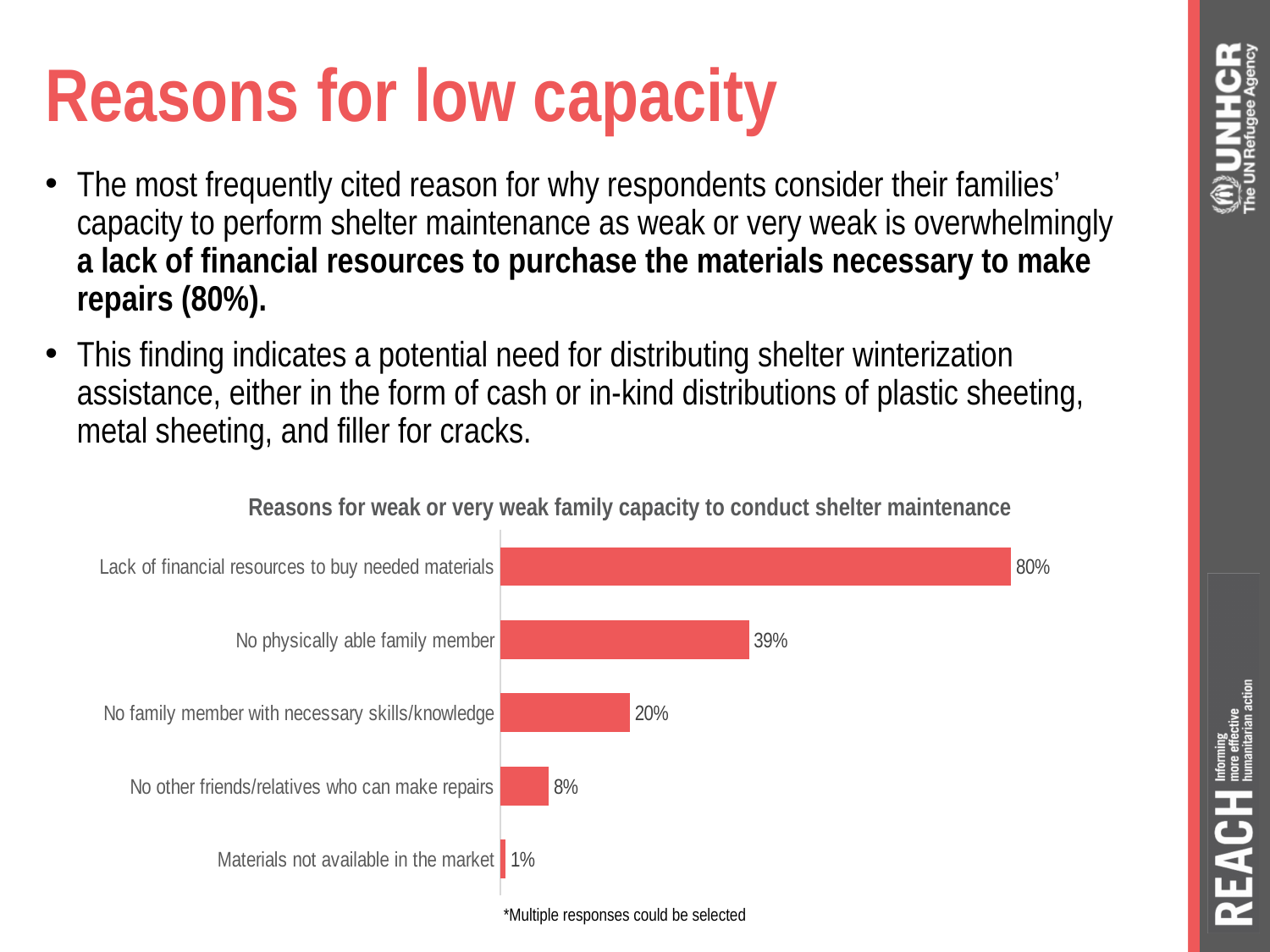
Which reason has the lowest value in the chart? Materials not available in the market What percentage of respondents cited 'Lack of financial resources to buy needed materials' as a reason? 80% Which reason has the highest value in the chart? Lack of financial resources to buy needed materials What is the difference between the values for 'Lack of financial resources to buy needed materials' and 'No physically able family member'? 41% What is the value for 'No family member with necessary skills/knowledge'? 20% What is the value for 'No other friends/relatives who can make repairs'? 8% What is the title of the chart? Reasons for weak or very weak family capacity to conduct shelter maintenance Which is larger: the value for 'No family member with necessary skills/knowledge' or 'No other friends/relatives who can make repairs'? No family member with necessary skills/knowledge How many reasons (categories) are shown in the chart? 5 What type of chart is shown on the slide? Bar chart What is the value for 'Materials not available in the market'? 1% What is the value for 'No physically able family member'? 39%